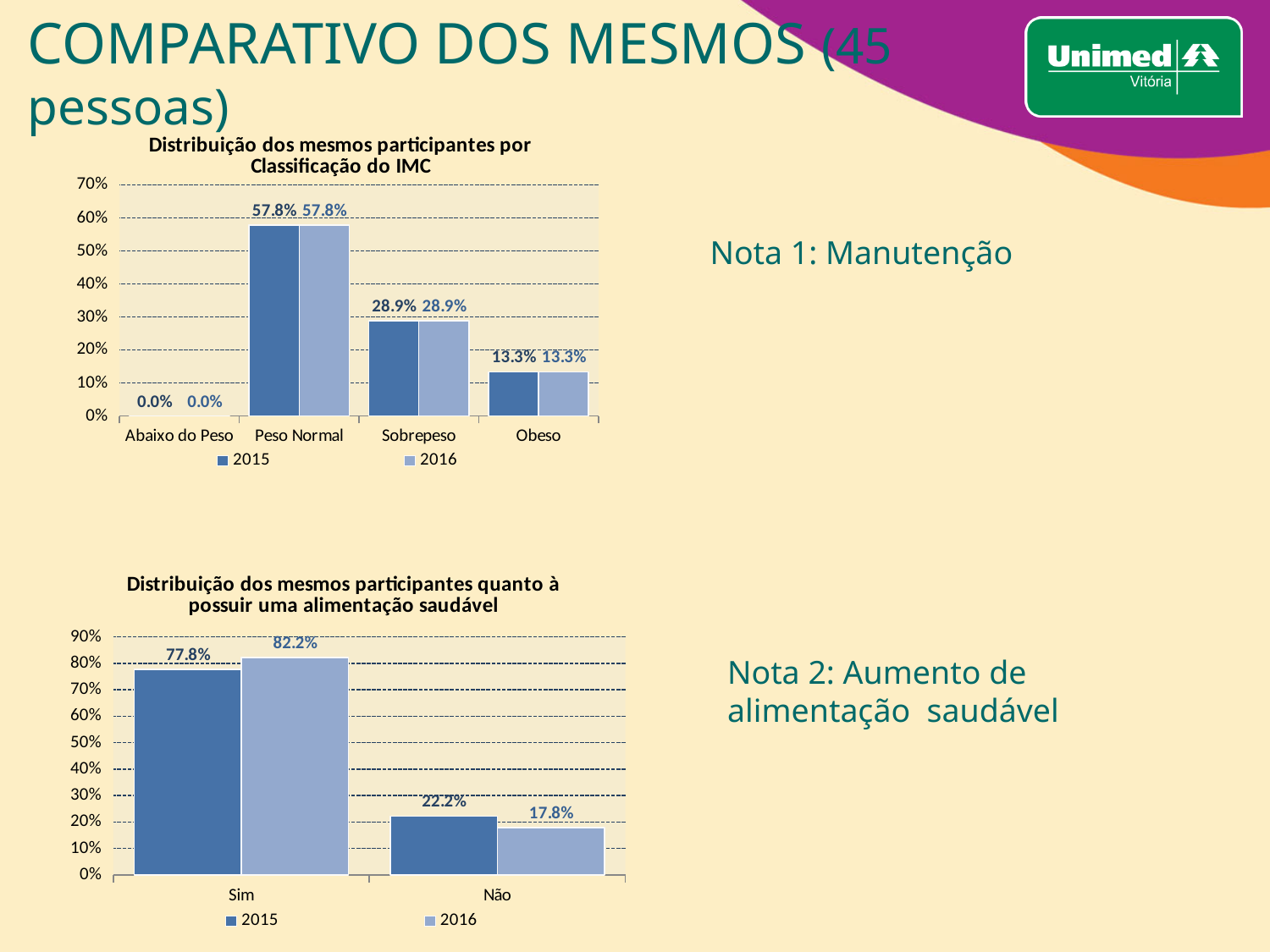
In the bottom chart (Distribuição dos mesmos participantes quanto à possuir uma alimentação saudável), what is the difference between the 2015 and 2016 values for Não? 4.4% In the bottom chart (Distribuição dos mesmos participantes quanto à possuir uma alimentação saudável), which is larger for Sim: the 2015 value or the 2016 value? 2016 In the top chart (Distribuição dos mesmos participantes por Classificação do IMC), what is the value for Peso Normal in 2015? 57.8% In the top chart (Distribuição dos mesmos participantes por Classificação do IMC), which category has the highest value in 2015? Peso Normal In the bottom chart (Distribuição dos mesmos participantes quanto à possuir uma alimentação saudável), what is the value for Não in 2015? 22.2% In the top chart (Distribuição dos mesmos participantes por Classificação do IMC), what is the value for Sobrepeso in 2016? 28.9% In the top chart (Distribuição dos mesmos participantes por Classificação do IMC), which category has the lowest value in 2016? Abaixo do Peso In the top chart (Distribuição dos mesmos participantes por Classificação do IMC), how many categories are shown on the x axis? 4 In the bottom chart (Distribuição dos mesmos participantes quanto à possuir uma alimentação saudável), how many series does the legend list? 2 In the top chart (Distribuição dos mesmos participantes por Classificação do IMC), what is the difference between the 2015 values for Sobrepeso and Obeso? 15.6% In the bottom chart (Distribuição dos mesmos participantes quanto à possuir uma alimentação saudável), what is the value for Sim in 2016? 82.2% What kind of chart is the bottom chart (Distribuição dos mesmos participantes quanto à possuir uma alimentação saudável)? Bar chart